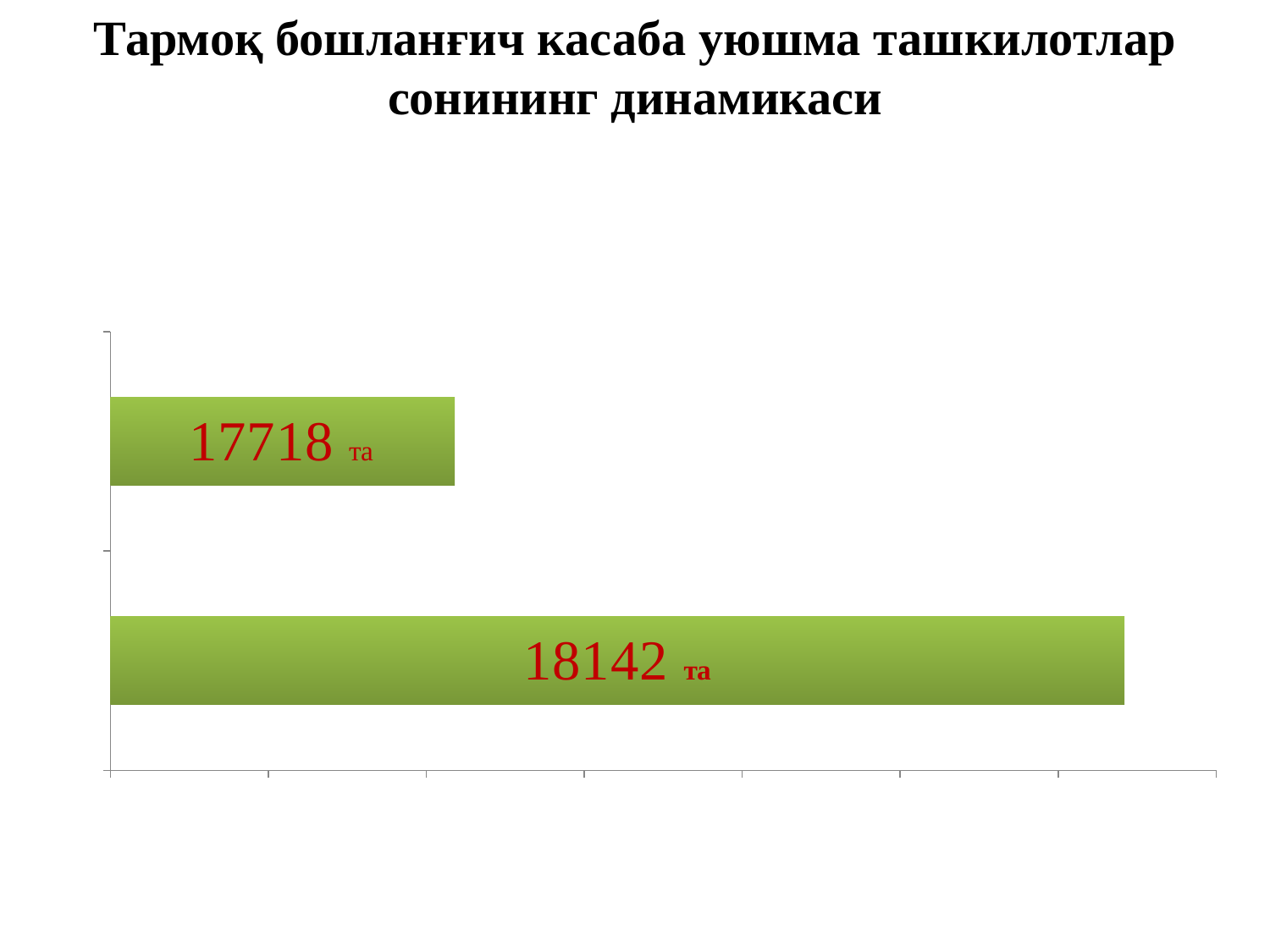
How many bars are plotted in the chart? 2 What value is printed on the top bar of the chart? 17718 та What colour are the bars in the chart? green Which bar has the lower value, the top bar or the bottom bar? the top bar Which bar has the higher value, the top bar or the bottom bar? the bottom bar What is the difference between the values of the bottom bar and the top bar? 424 Is the value of the top bar larger or smaller than the value of the bottom bar? smaller What type of chart is shown on the slide? bar chart What value is printed on the bottom bar of the chart? 18142 та What is the title of the slide containing the chart? Тармоқ бошланғич касаба уюшма ташкилотлар сонининг динамикаси